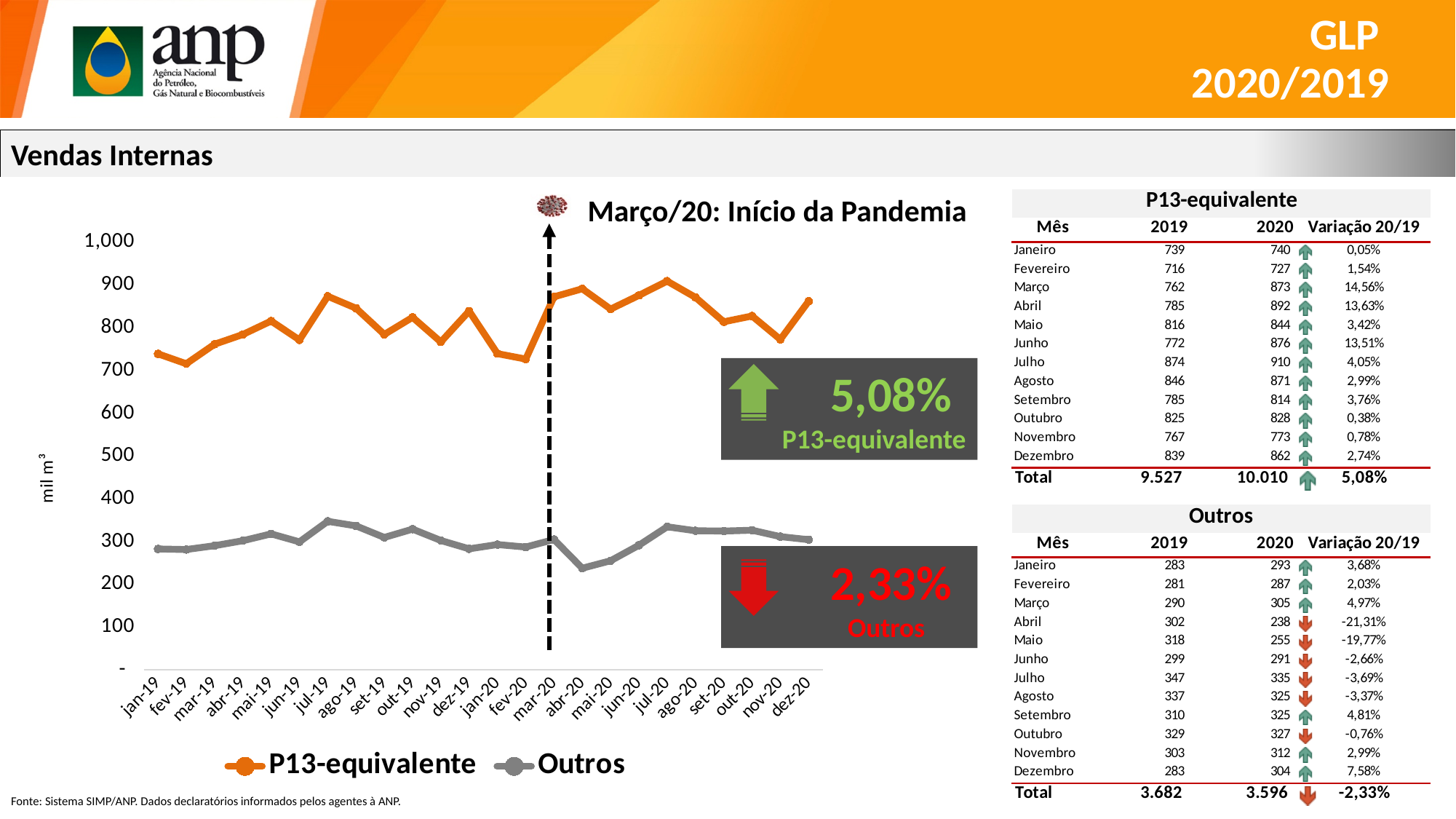
According to the Outros table, what is the Variação 20/19 for the total? -2,33% How many series does the chart legend list? 2 What kind of chart is shown on the slide? line chart Is the value for Outros in abr-20 greater or less than 300? less In which month does the P13-equivalente line reach its highest point? jul-20 What is the difference between the P13-equivalente values for Março in 2020 and 2019, as printed in the table? 111 Is the value for P13-equivalente in jul-20 greater or less than 800? greater In jan-19, which series has the larger value, P13-equivalente or Outros? P13-equivalente According to the P13-equivalente table, what is the total for 2019? 9.527 In which month does the Outros line reach its lowest point? abr-20 How many monthly points are plotted for each series on the x axis? 24 What event does the dashed vertical line on the chart mark? Março/20: Início da Pandemia